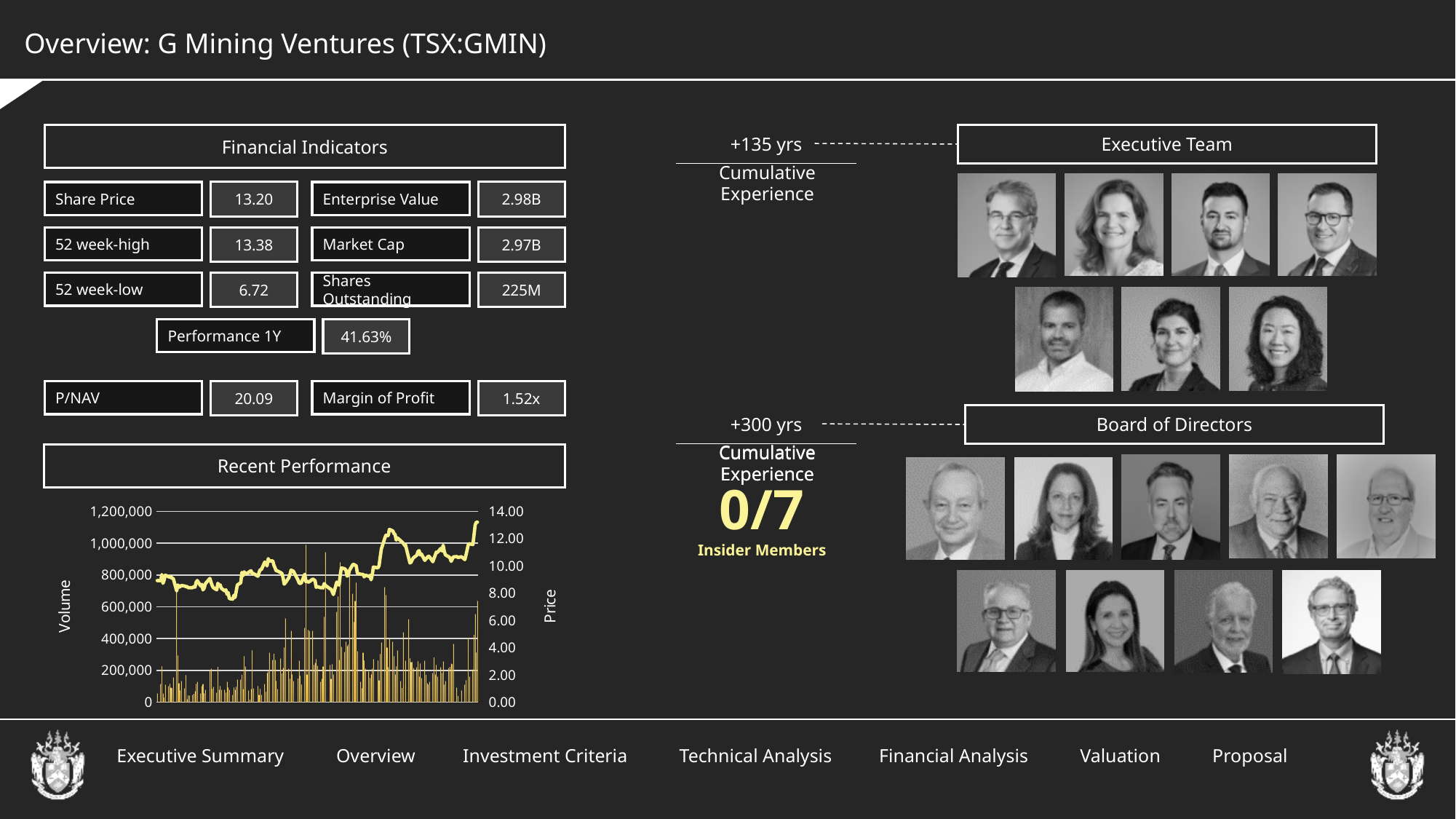
What kind of chart is the Recent Performance chart? A combined bar and line chart Does the price line on the Recent Performance chart rise or fall overall from left to right? Rise On the Recent Performance chart, is the price at the right end of the line greater or less than the price at the left end? greater What is the highest tick value shown on the left (Volume) axis of the Recent Performance chart? 1,200,000 What is the title of the chart on the slide? Recent Performance On the Recent Performance chart, is the price at the left end of the line greater or less than 10.00? less What is the lowest tick value shown on the right (Price) axis of the Recent Performance chart? 0.00 On the Recent Performance chart, is the price at the right end of the line greater or less than 12.00? greater What is the label of the left vertical axis on the Recent Performance chart? Volume What is the highest tick value shown on the right (Price) axis of the Recent Performance chart? 14.00